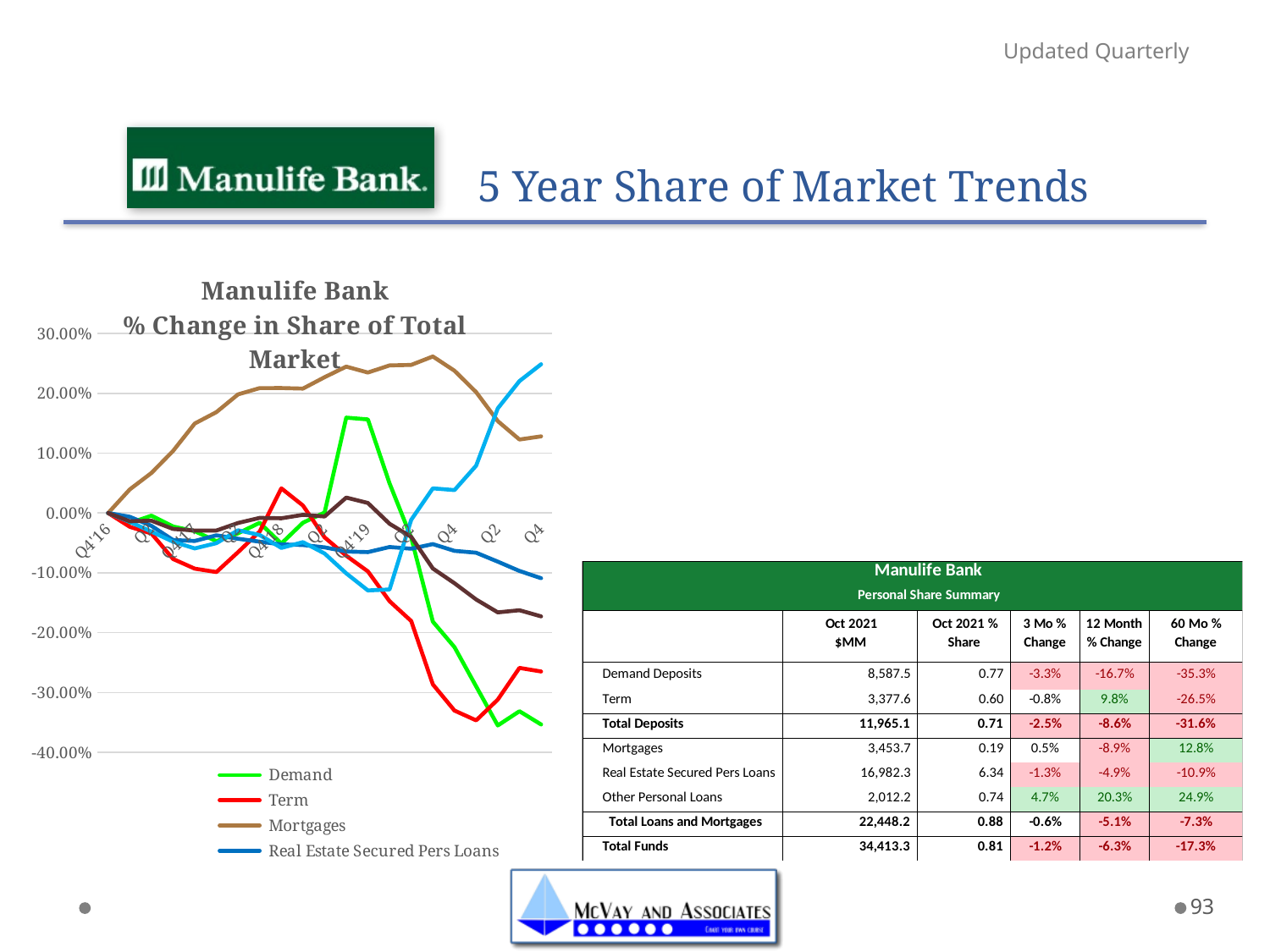
At the final point, which is larger: the value for Mortgages or the value for Demand? Mortgages How many series does the chart legend list? 4 Does the Demand line overall rise or fall from Q4'16 to the final Q4? fall Which series is drawn in brown on the chart? Mortgages What kind of chart is shown on the slide? line chart Is the value for Demand at the final point greater or less than -30.00%? less Which series has the lowest value at the final point (Q4) on the chart? Demand What is the title of the chart? Manulife Bank % Change in Share of Total Market Is the value for Term at the final point greater or less than -20.00%? less Is the peak value of the Mortgages line greater or less than 20.00%? greater